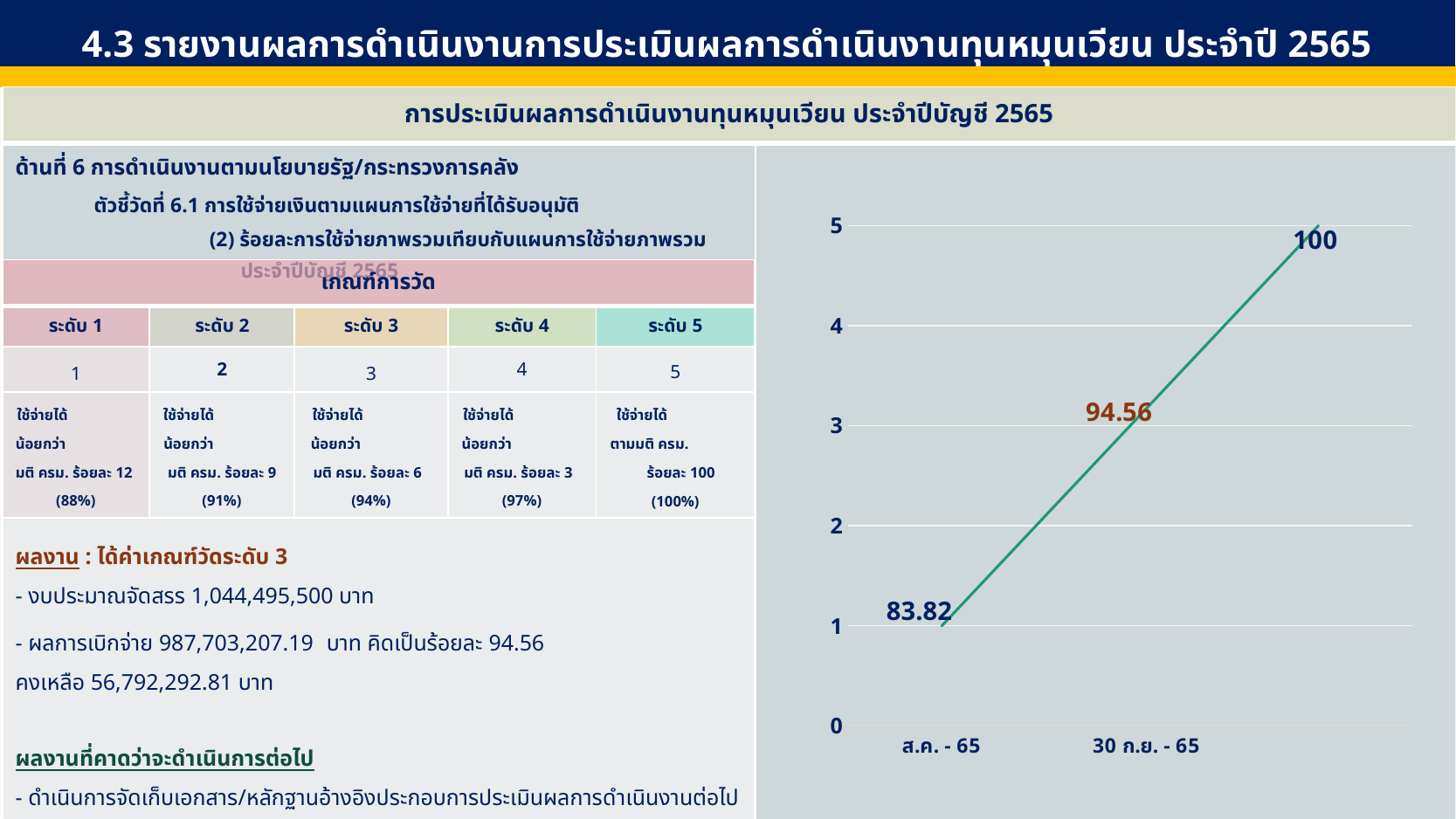
Which data label on the line chart is the highest? 100 Is the line's position at ส.ค. - 65 greater or less than 2 on the y axis? less Which x-axis category has the higher point on the line chart, ส.ค. - 65 or 30 ก.ย. - 65? 30 ก.ย. - 65 What is the difference between the data labels 100 and 83.82 on the line chart? 16.18 Does the line in the chart rise or fall from ส.ค. - 65 to 30 ก.ย. - 65? rise What is the middle data label shown on the line chart? 94.56 What is the highest tick value shown on the y axis of the line chart? 5 What data label is shown at the 30 ก.ย. - 65 end of the line chart? 100 How many categories are shown on the x axis of the line chart? 2 Which data label on the line chart is the lowest? 83.82 What data label is shown at the ส.ค. - 65 point of the line chart? 83.82 What kind of chart is shown on the right side of the slide? line chart